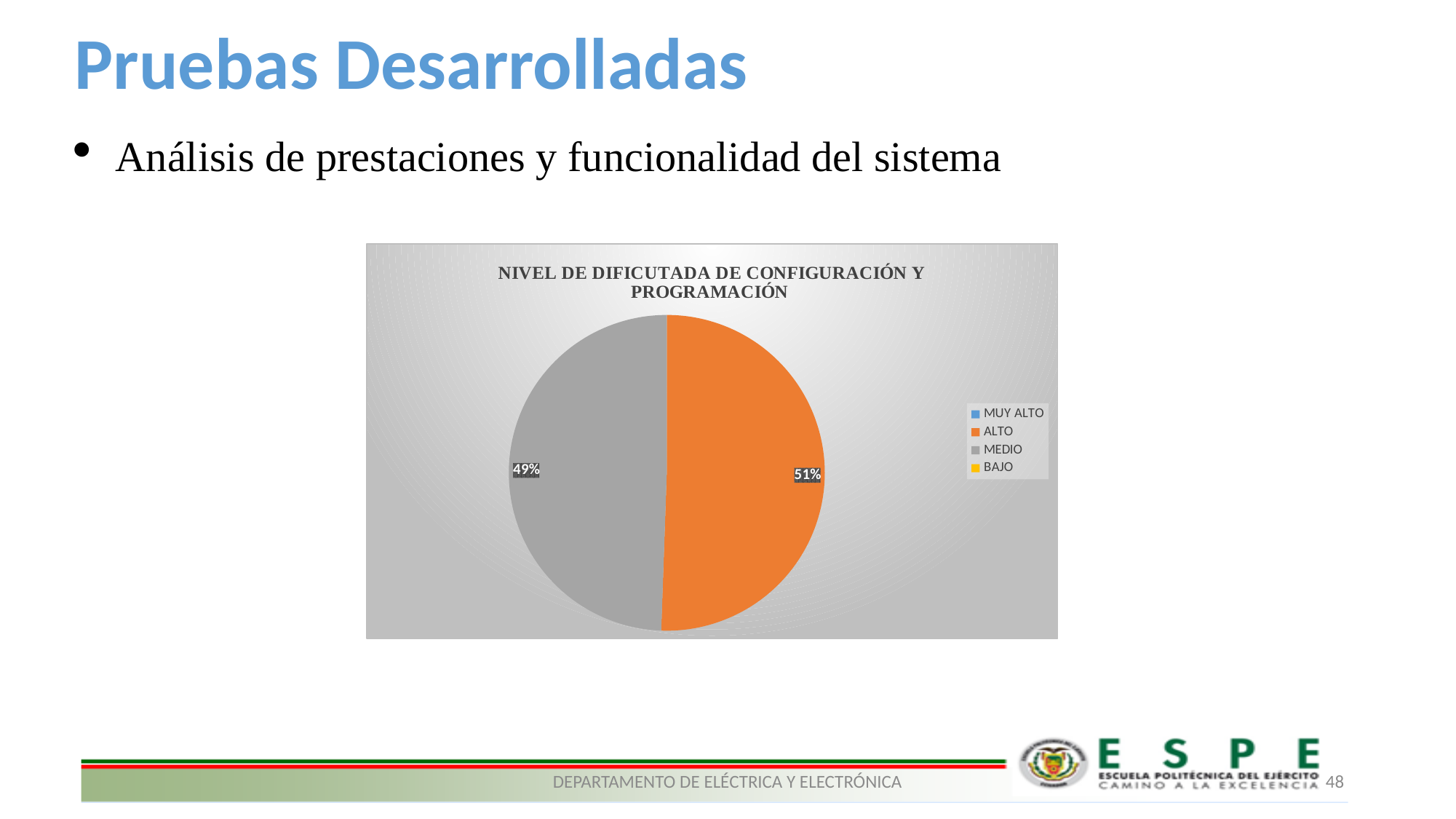
By how many percentage points does the ALTO slice exceed the MEDIO slice? 2 percentage points What is the title of the chart? NIVEL DE DIFICUTADA DE CONFIGURACIÓN Y PROGRAMACIÓN Which of the two labelled slices is smaller, ALTO or MEDIO? MEDIO What colour represents the ALTO category in the chart? orange Is the share of the ALTO slice greater or less than 50%? greater What percentage is shown for the ALTO slice? 51% How many categories does the legend list? 4 What percentage is shown for the MEDIO slice? 49% How many slices with data labels are visible in the pie? 2 Which category has the largest slice of the pie? ALTO Is the share of the MEDIO slice greater or less than 50%? less What kind of chart is shown on the slide? pie chart